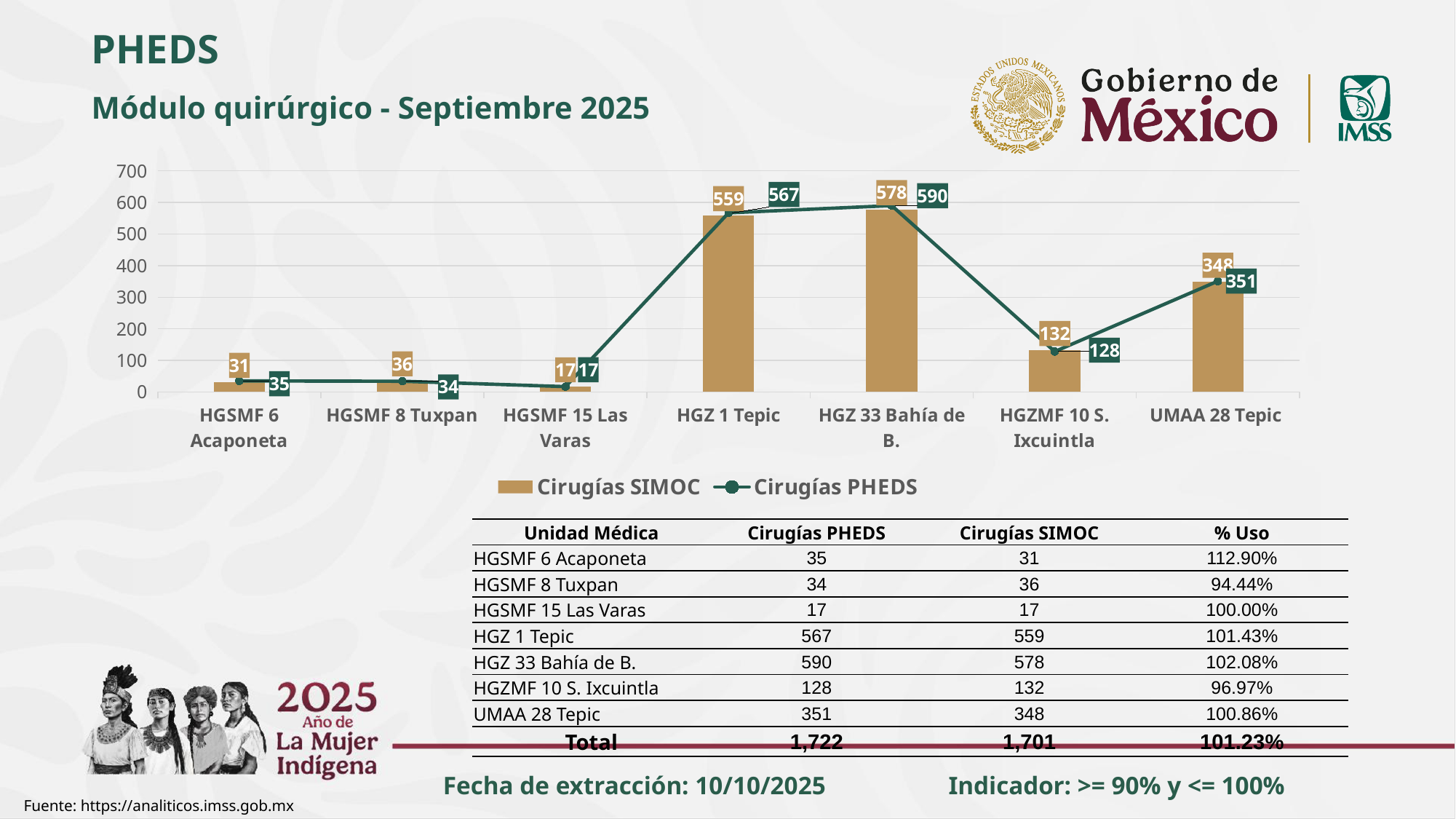
Which series is drawn as a line with markers in the chart? Cirugías PHEDS What kind of chart is used to show Cirugías SIMOC? Bar chart How many medical units are shown on the x axis of the chart? 7 What is the Cirugías PHEDS value for HGZMF 10 S. Ixcuintla? 128 Which unit has the highest Cirugías SIMOC value? HGZ 33 Bahía de B. What is the Cirugías SIMOC value for HGZ 1 Tepic? 559 Is the Cirugías SIMOC value for UMAA 28 Tepic greater or less than 300? greater Which unit has the lowest Cirugías PHEDS value? HGSMF 15 Las Varas Which is larger for HGSMF 8 Tuxpan: Cirugías SIMOC or Cirugías PHEDS? Cirugías SIMOC What is the difference between the Cirugías PHEDS and Cirugías SIMOC values for HGZ 33 Bahía de B.? 12 What is the Cirugías PHEDS value for UMAA 28 Tepic? 351 How many series does the chart legend list? 2